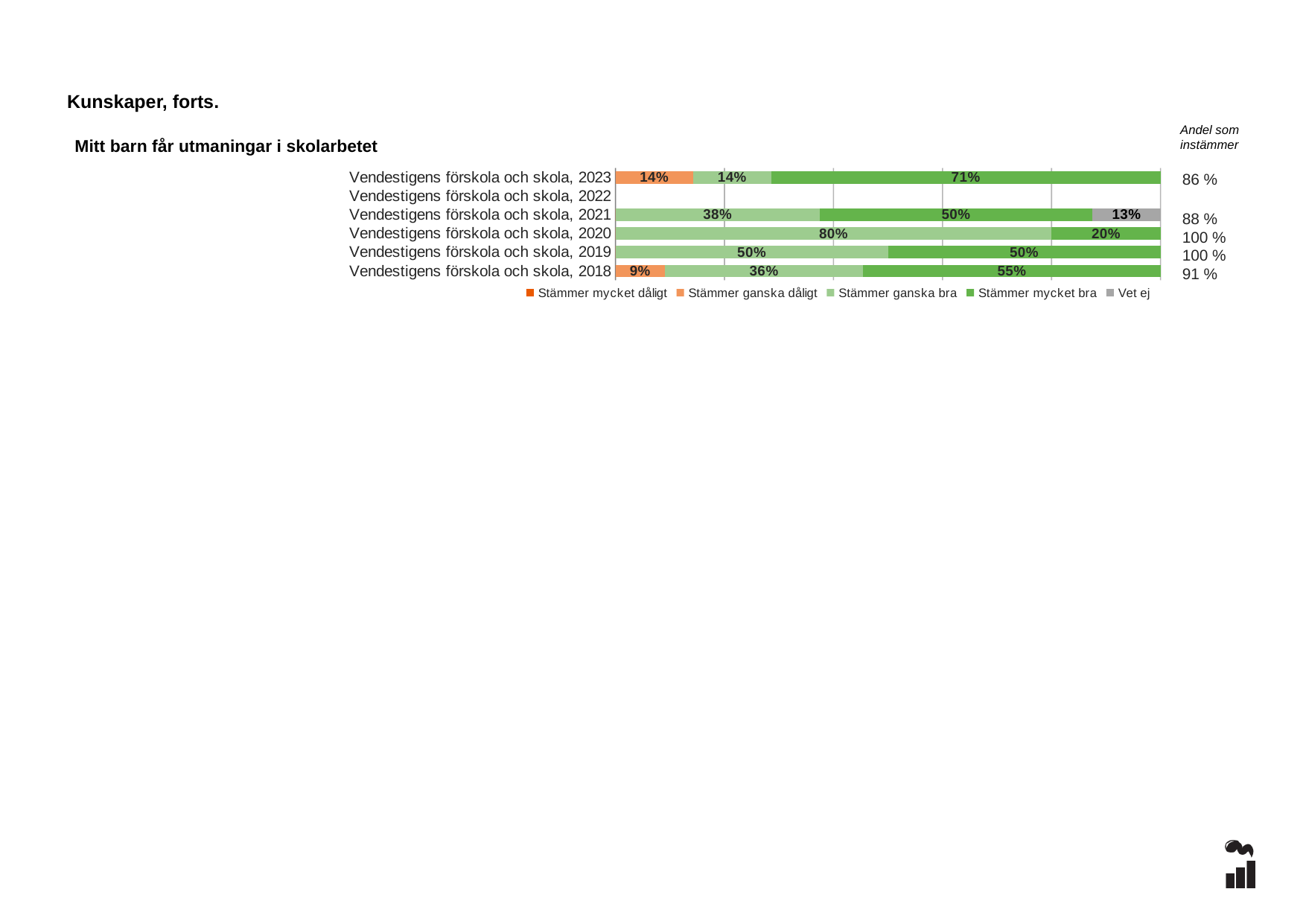
What is the "Andel som instämmer" value shown for Vendestigens förskola och skola, 2020? 100 % Which year has the highest "Stämmer mycket bra" share? 2023 What percentage answered "Stämmer mycket bra" for Vendestigens förskola och skola, 2023? 71% How many series does the legend list? 5 Among the years with data, which year has the lowest "Stämmer mycket bra" share? 2020 What percentage answered "Stämmer ganska bra" for Vendestigens förskola och skola, 2020? 80% How many category rows are listed on the chart's vertical axis? 6 What is the "Stämmer ganska dåligt" share for Vendestigens förskola och skola, 2018? 9% For 2018, how many percentage points larger is "Stämmer mycket bra" than "Stämmer ganska bra"? 19 percentage points What kind of chart is shown on the slide? Stacked bar chart What is the "Vet ej" share for Vendestigens förskola och skola, 2021? 13% For 2021, which is larger: "Stämmer ganska bra" or "Stämmer mycket bra"? Stämmer mycket bra